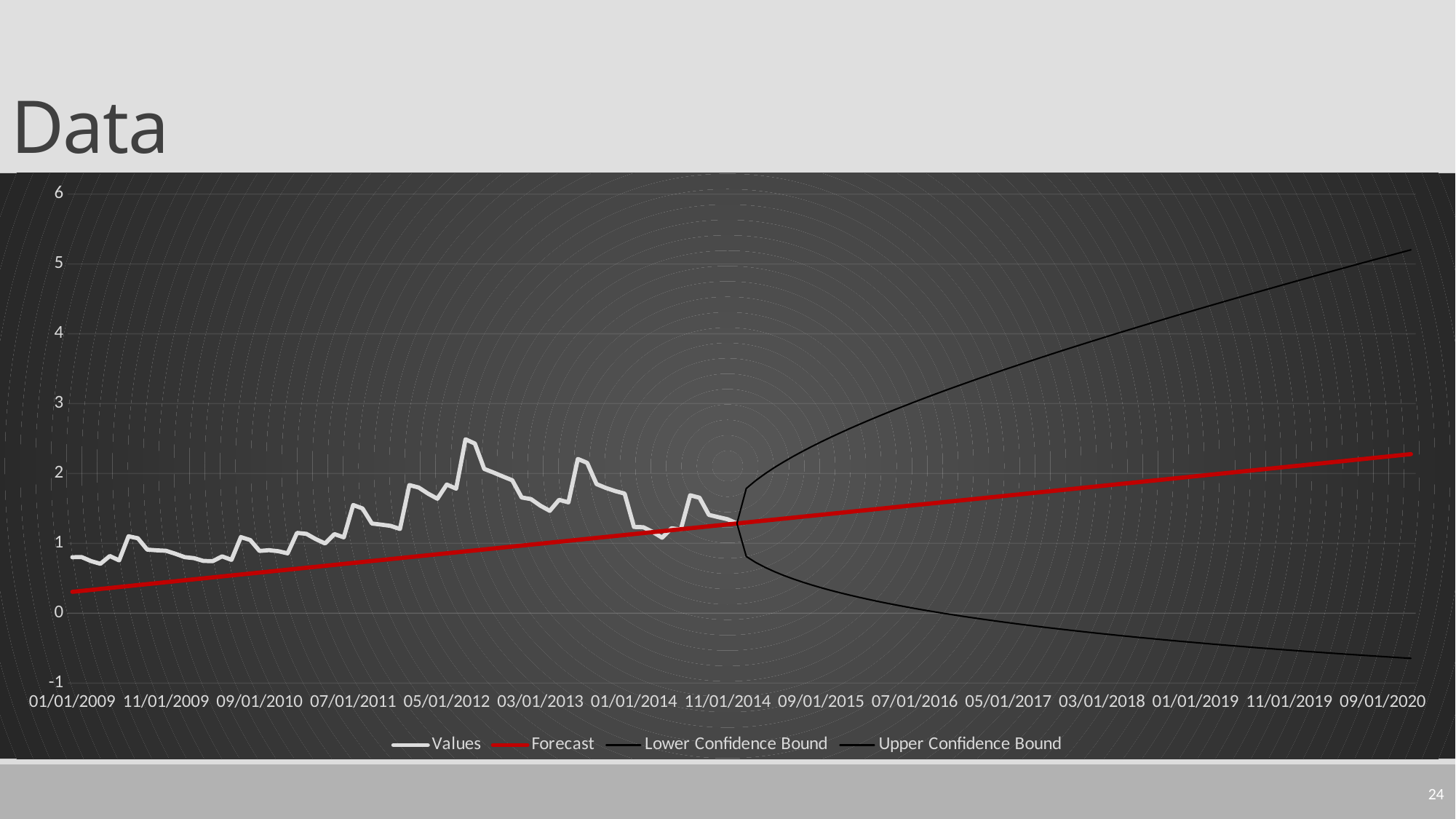
Is the Lower Confidence Bound value at 09/01/2020 greater or less than 0? less How many series does the legend list? 4 What kind of chart is shown on the slide? Line chart Is the Upper Confidence Bound value at 09/01/2020 greater or less than 4? greater Does the Lower Confidence Bound line rise or fall as it moves toward 09/01/2020? Falls At 09/01/2020, which is larger: the Upper Confidence Bound or the Forecast? Upper Confidence Bound Which series reaches the highest point anywhere on the chart? Upper Confidence Bound What is the title of the slide containing the chart? Data Is the Forecast value at 01/01/2009 greater or less than 1? less Does the Forecast line rise or fall from left to right along the x axis? Rises Which series is drawn in red? Forecast